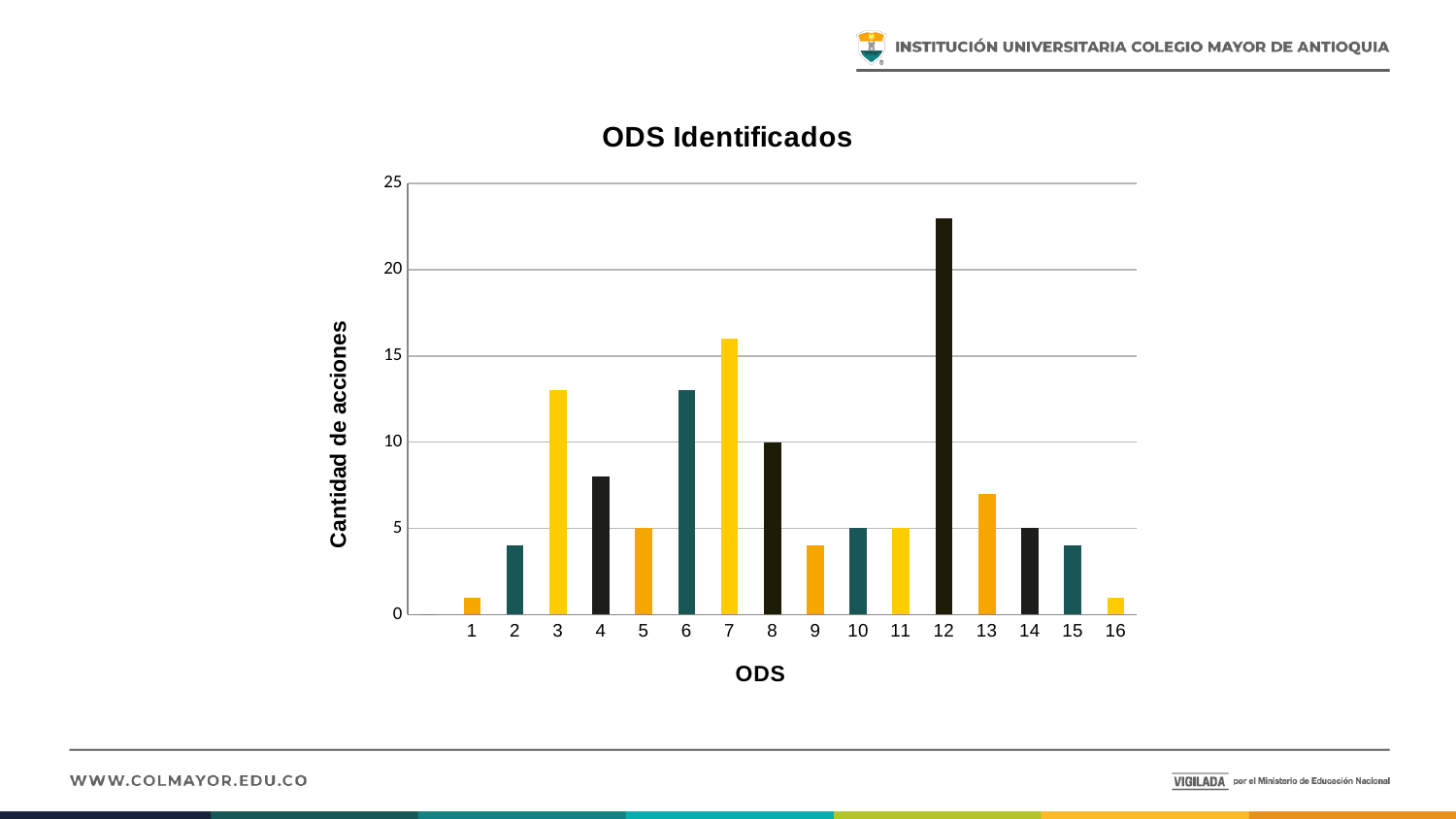
Is the value for ODS 12 greater or less than 20? greater Which has more actions, ODS 7 or ODS 3? ODS 7 What is the value for ODS 5? 5 Is the value for ODS 7 greater or less than 15? greater What type of chart is shown on the slide? bar chart What is the value for ODS 8? 10 How many ODS categories are shown on the x axis? 16 What is the label of the vertical axis? Cantidad de acciones Which ODS has the highest number of actions? 12 What is the title of the chart? ODS Identificados What is the value for ODS 14? 5 Is the value for ODS 4 greater or less than 10? less